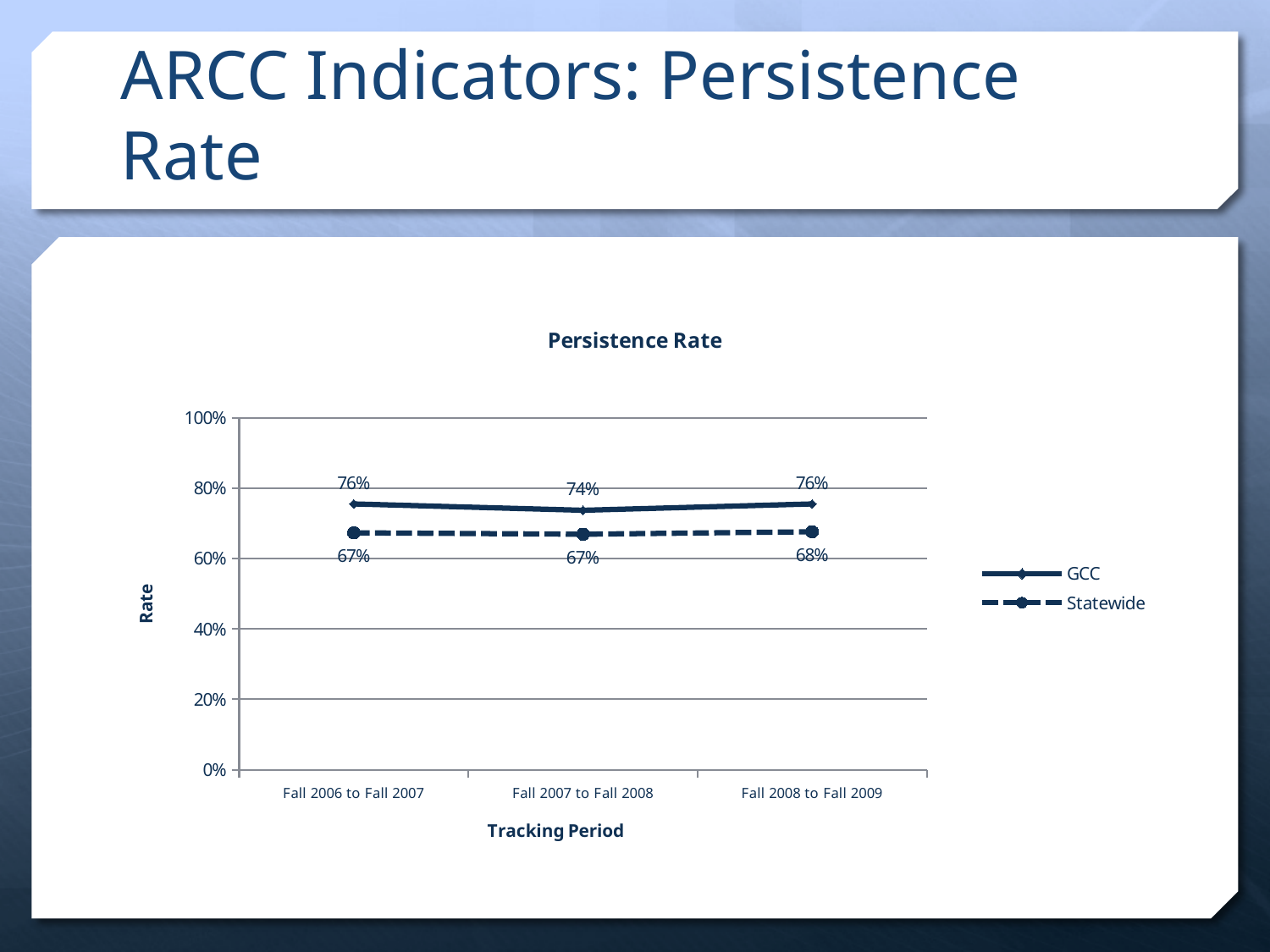
What is the difference between the GCC and Statewide persistence rates for Fall 2006 to Fall 2007? 9% What is the GCC persistence rate for Fall 2007 to Fall 2008? 74% Which series has the higher persistence rate for Fall 2007 to Fall 2008, GCC or Statewide? GCC What is the Statewide persistence rate for Fall 2007 to Fall 2008? 67% How many tracking periods are shown on the x axis? 3 In which tracking period is the GCC persistence rate lowest? Fall 2007 to Fall 2008 What is the Statewide persistence rate for Fall 2008 to Fall 2009? 68% What is the difference between the GCC and Statewide persistence rates for Fall 2008 to Fall 2009? 8% How many series does the legend list? 2 What is the title of the chart? Persistence Rate What kind of chart is shown on the slide? Line chart What is the GCC persistence rate for Fall 2006 to Fall 2007? 76%